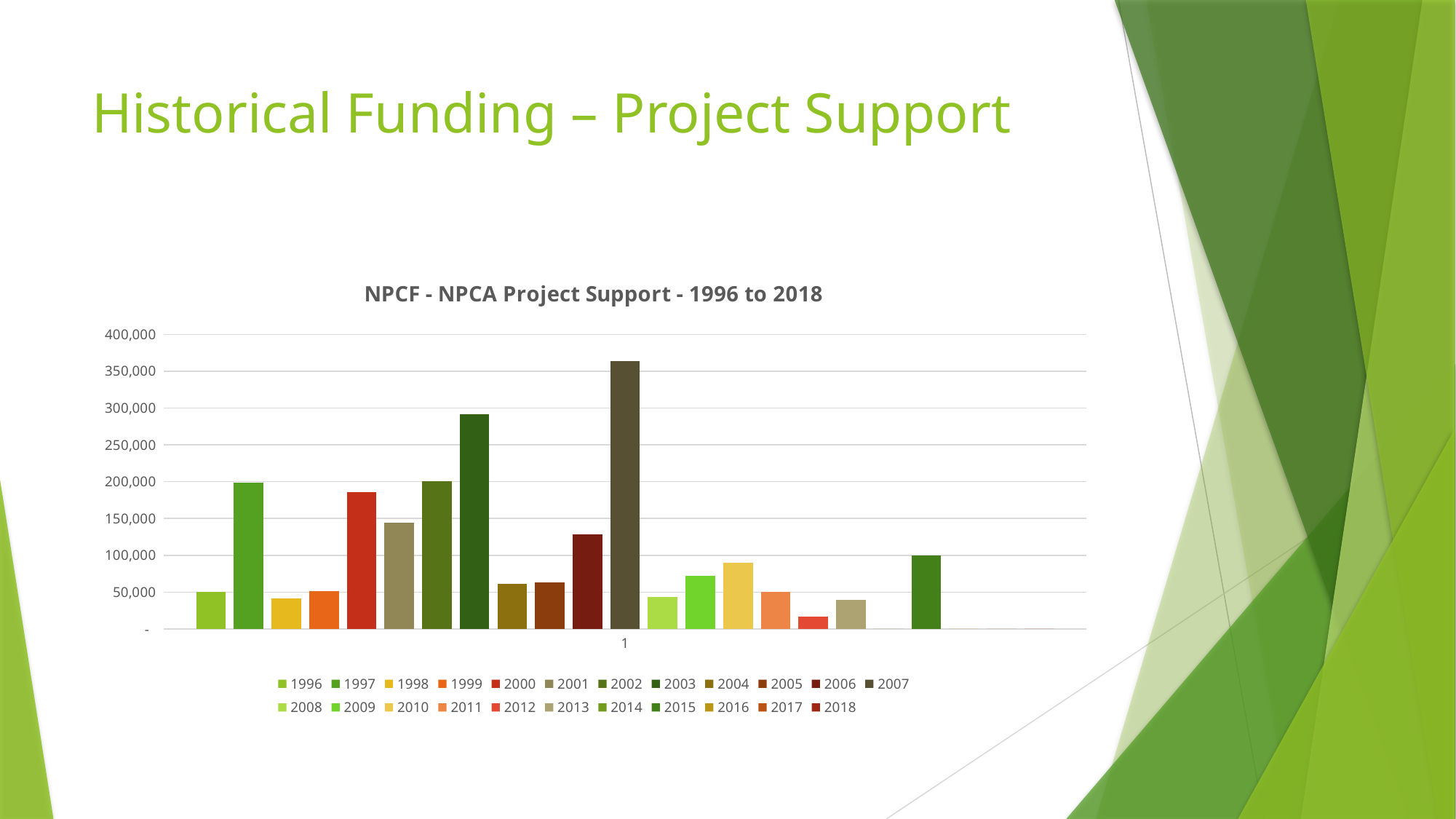
Is the value for 1998 greater or less than 50,000? less What kind of chart is shown on the slide? Bar chart Is the value for 2006 greater or less than 100,000? greater How many series does the chart legend list? 23 Which is larger, the value for 2003 or the value for 2007? 2007 What is the title of the chart? NPCF - NPCA Project Support - 1996 to 2018 Is the value for 2012 greater or less than 50,000? less Which year has the tallest bar in the chart? 2007 Which is larger, the value for 1997 or the value for 2001? 1997 Which is larger, the value for 2010 or the value for 2013? 2010